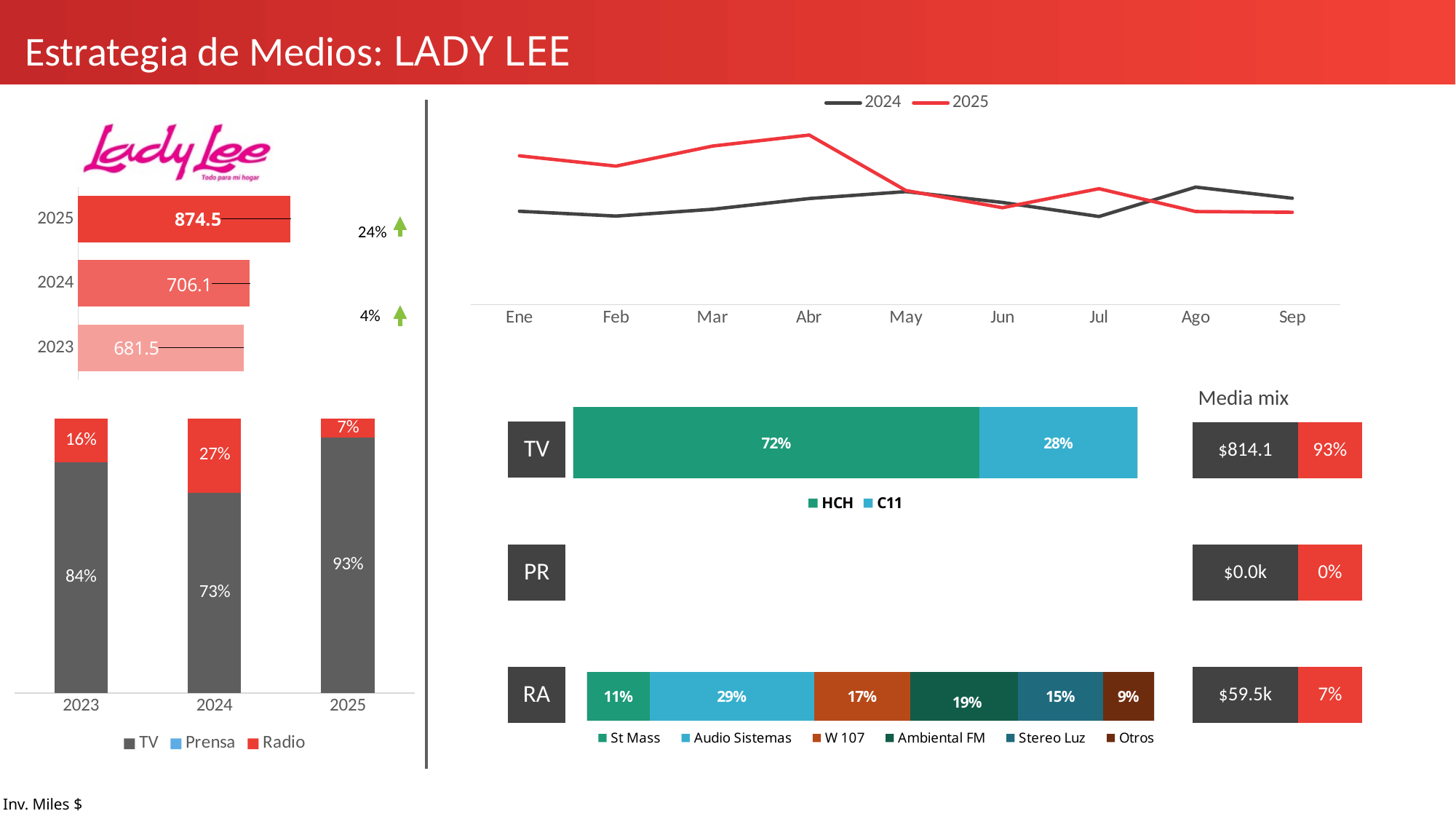
In the horizontal bar chart of yearly investment on the left, which year has the lowest value? 2023 In the RA stacked bar at the bottom right, which station has the largest share? Audio Sistemas In the horizontal bar chart of yearly investment on the left, what is the value for 2023? 681.5 In the TV stacked bar in the middle right, what is the share for HCH? 72% In the stacked bar chart at the bottom left, what is the Radio share for 2025? 7% In the horizontal bar chart of yearly investment on the left, what is the value for 2025? 874.5 In the horizontal bar chart of yearly investment on the left, what is the difference between the 2025 and 2024 values? 168.4 In the Media mix boxes on the right, what is the value shown for RA? $59.5k In the line chart at the top right, how many months are shown on the x axis? 9 In the stacked bar chart at the bottom left, how many series does the legend list? 3 In the line chart at the top right, which series is higher in Abr, 2024 or 2025? 2025 In the stacked bar chart at the bottom left, what is the TV share for 2024? 73%